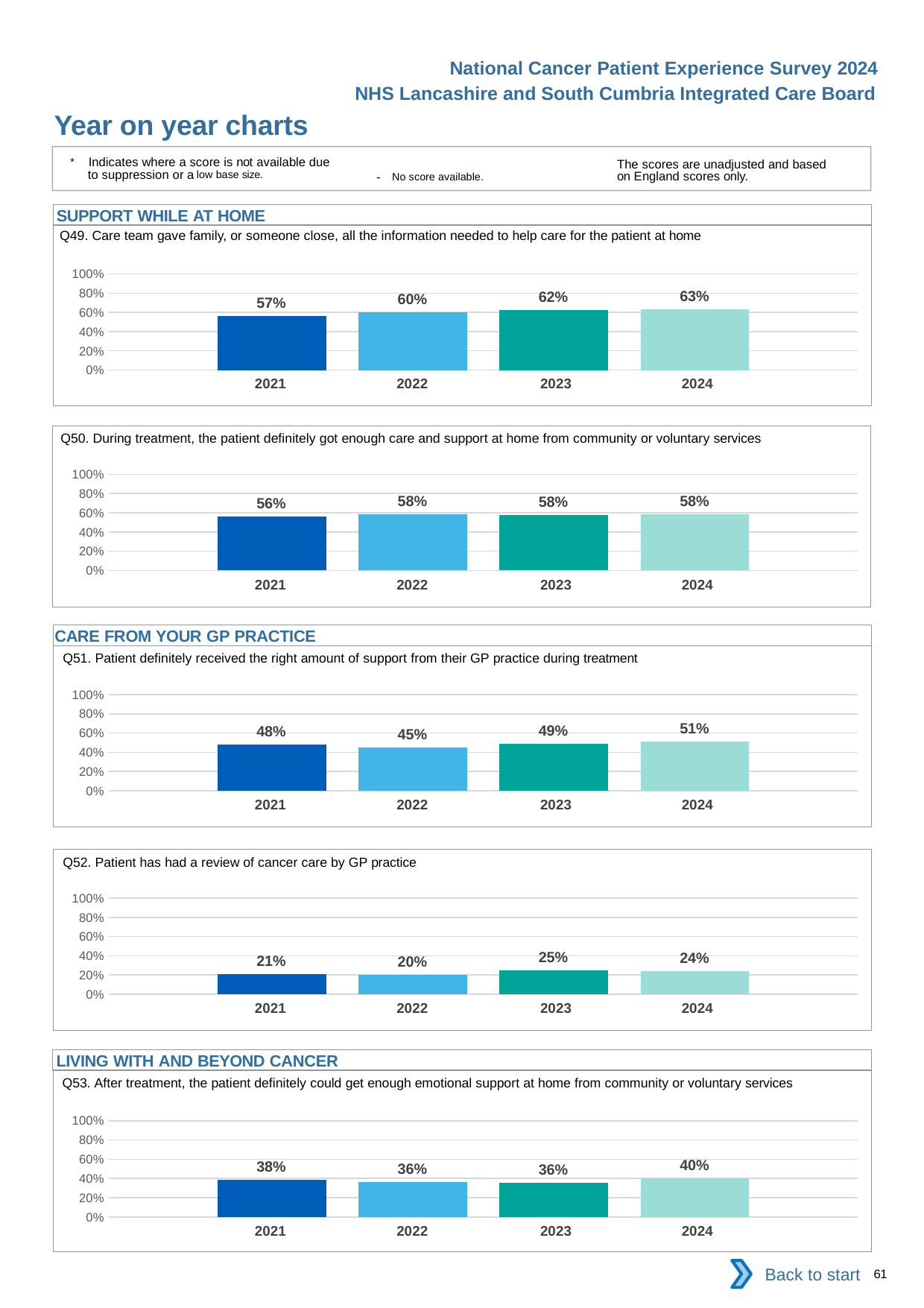
What kind of chart is used for Q49? Bar chart In the Q53 chart, what is the difference between the 2024 and 2023 values? 4% In the Q49 chart, which year has the lowest value? 2021 In the Q49 chart, what is the value for 2024? 63% In the Q53 chart, how many years are plotted? 4 In the Q51 chart, which year has the highest value? 2024 In the Q52 chart, what is the value for 2023? 25% In the Q49 chart, do the values rise or fall from 2021 to 2024? Rise In the Q52 chart, is the value for 2022 greater or less than 40%? less In the Q51 chart, which is larger, the value for 2021 or the value for 2022? 2021 In the Q50 chart, what is the value for 2021? 56% In the Q50 chart, what is the difference between the 2022 and 2021 values? 2%